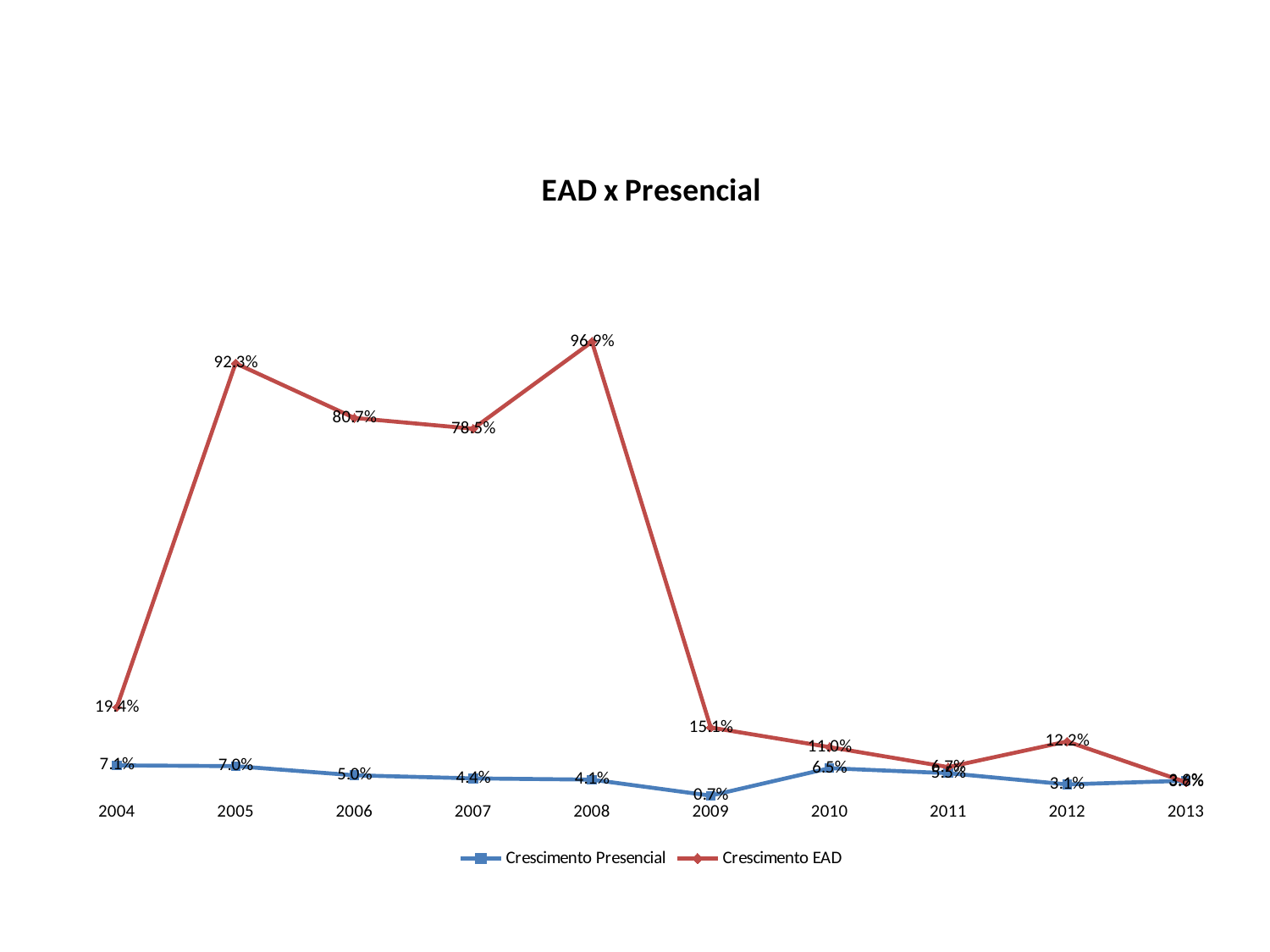
What is the difference between the Crescimento EAD values for 2005 and 2006? 11.6 percentage points How many series does the legend list? 2 What is the title of the chart? EAD x Presencial Which year has the larger Crescimento EAD value, 2005 or 2008? 2008 In which year is Crescimento Presencial lowest? 2009 Does the Crescimento EAD value rise or fall from 2008 to 2009? Fall How many years are shown on the x axis? 10 In which year is Crescimento EAD highest? 2008 What is the Crescimento Presencial value for 2009? 0.7% What is the Crescimento EAD value for 2004? 19.4% What is the Crescimento EAD value for 2008? 96.9% What kind of chart is shown on the slide? Line chart